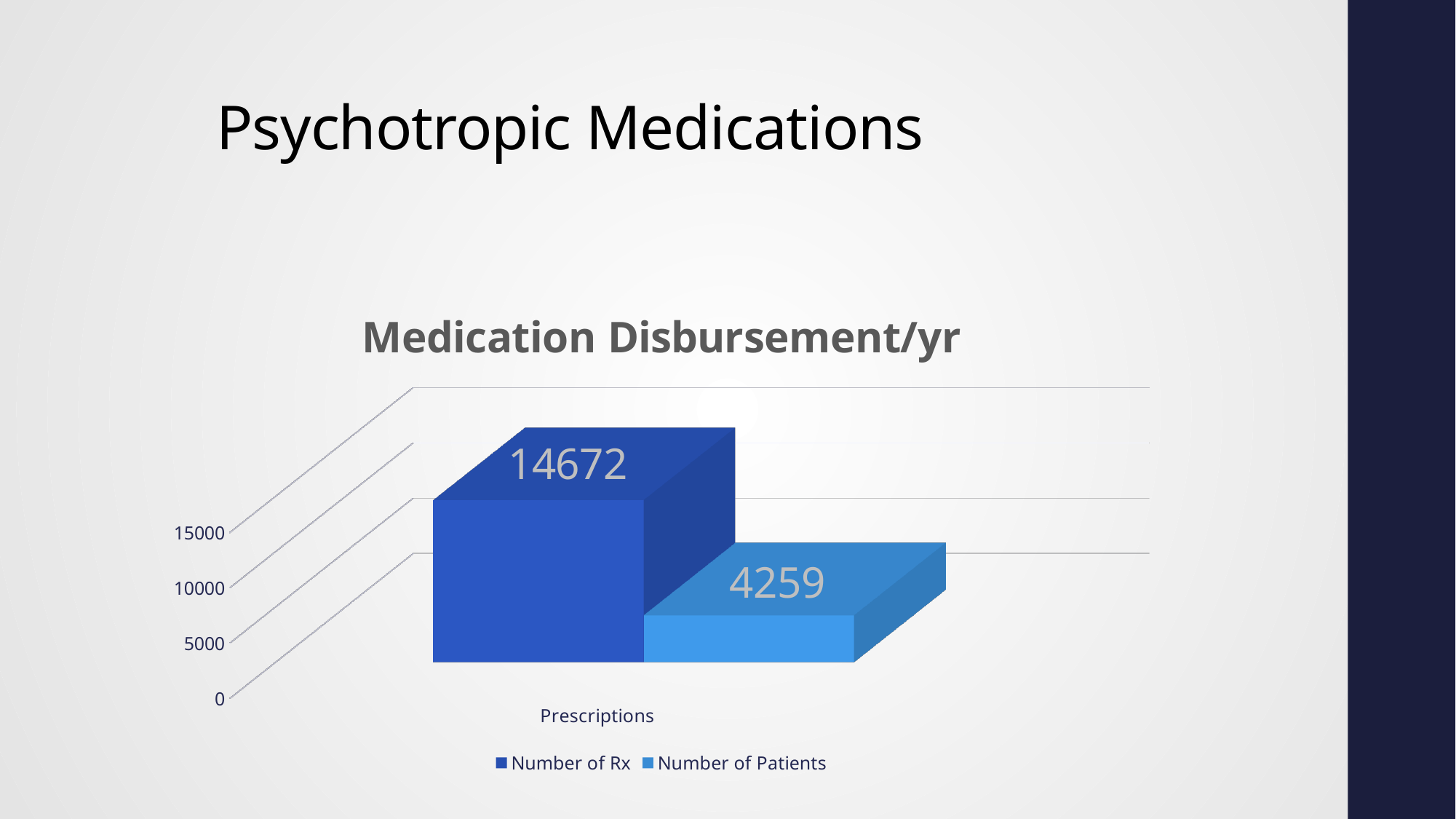
Is the value for Number of Rx greater or less than 10000? greater What is the value for Number of Patients in the Medication Disbursement/yr chart? 4259 How many series does the legend list? 2 How many categories are shown on the x axis? 1 What kind of chart is shown on the slide? bar chart Which series has the higher value, Number of Rx or Number of Patients? Number of Rx Which series has the lowest value in the chart? Number of Patients What is the value for Number of Rx in the Medication Disbursement/yr chart? 14672 Is the value for Number of Patients greater or less than 5000? less What is the difference between Number of Rx and Number of Patients? 10413 What is the label of the category on the x axis? Prescriptions What is the title of the chart? Medication Disbursement/yr